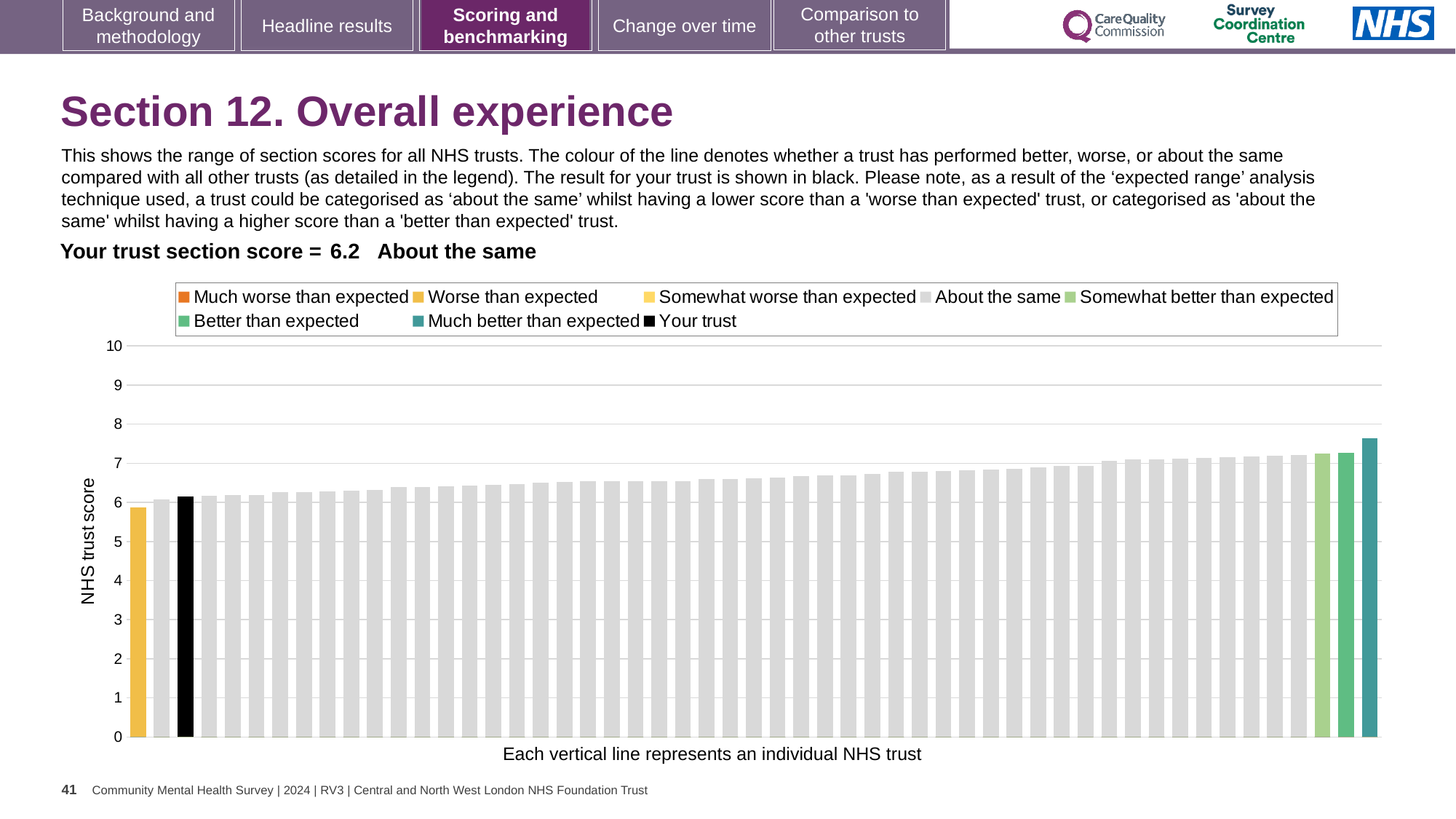
What kind of chart is shown on the slide? bar chart Is the value of the tallest bar greater or less than 8? less How many entries does the chart legend list? 8 Is the value of the shortest (yellow) bar greater or less than 5? greater Which legend category does the tallest bar in the chart belong to? Much better than expected Is the value of the tallest bar greater or less than 7? greater Which legend category does the shortest bar in the chart belong to? Worse than expected What is the section score for your trust shown on the slide? 6.2 What is the label on the vertical axis of the chart? NHS trust score Which is taller: the black bar for your trust or the yellow 'Worse than expected' bar? the black bar (Your trust) Do the bar values rise or fall from left to right across the chart? rise Which benchmarking category is your trust placed in for Section 12? About the same